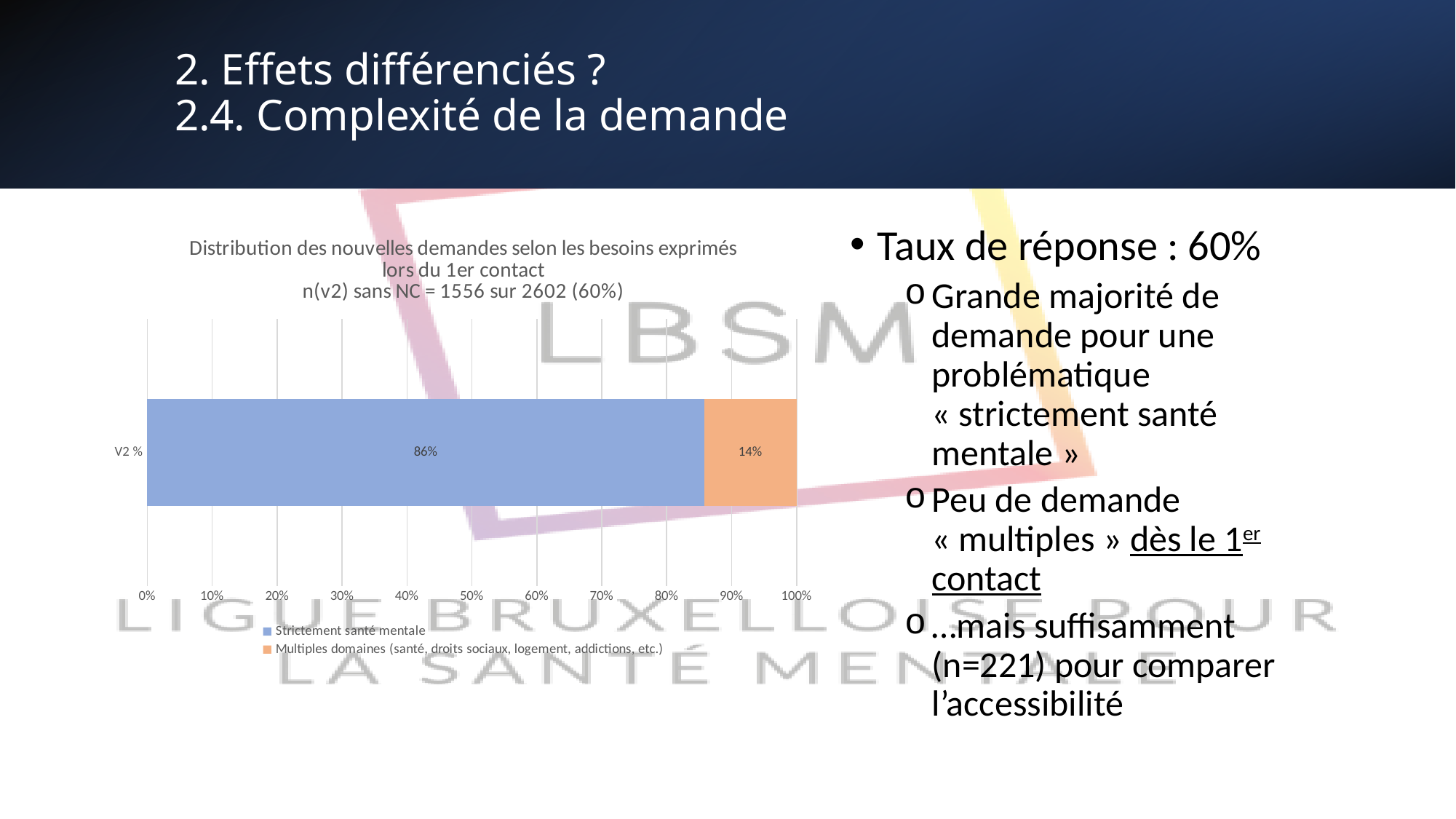
Which series has the smaller share of the V2 % bar? Multiples domaines (santé, droits sociaux, logement, addictions, etc.) What kind of chart is shown on the slide? Stacked bar chart What is the total of the stacked V2 % bar? 100% What is the difference between the "Strictement santé mentale" value and the "Multiples domaines" value? 72% Is the value for "Strictement santé mentale" larger or smaller than the value for "Multiples domaines"? larger What is the value for "Strictement santé mentale" in the V2 % bar? 86% Which series has the larger share of the V2 % bar? Strictement santé mentale How many series does the legend list? 2 Is the value for "Multiples domaines" greater or less than 20%? less Is the value for "Strictement santé mentale" greater or less than 80%? greater What is the category label on the vertical axis of the chart? V2 % What is the value for "Multiples domaines (santé, droits sociaux, logement, addictions, etc.)" in the V2 % bar? 14%